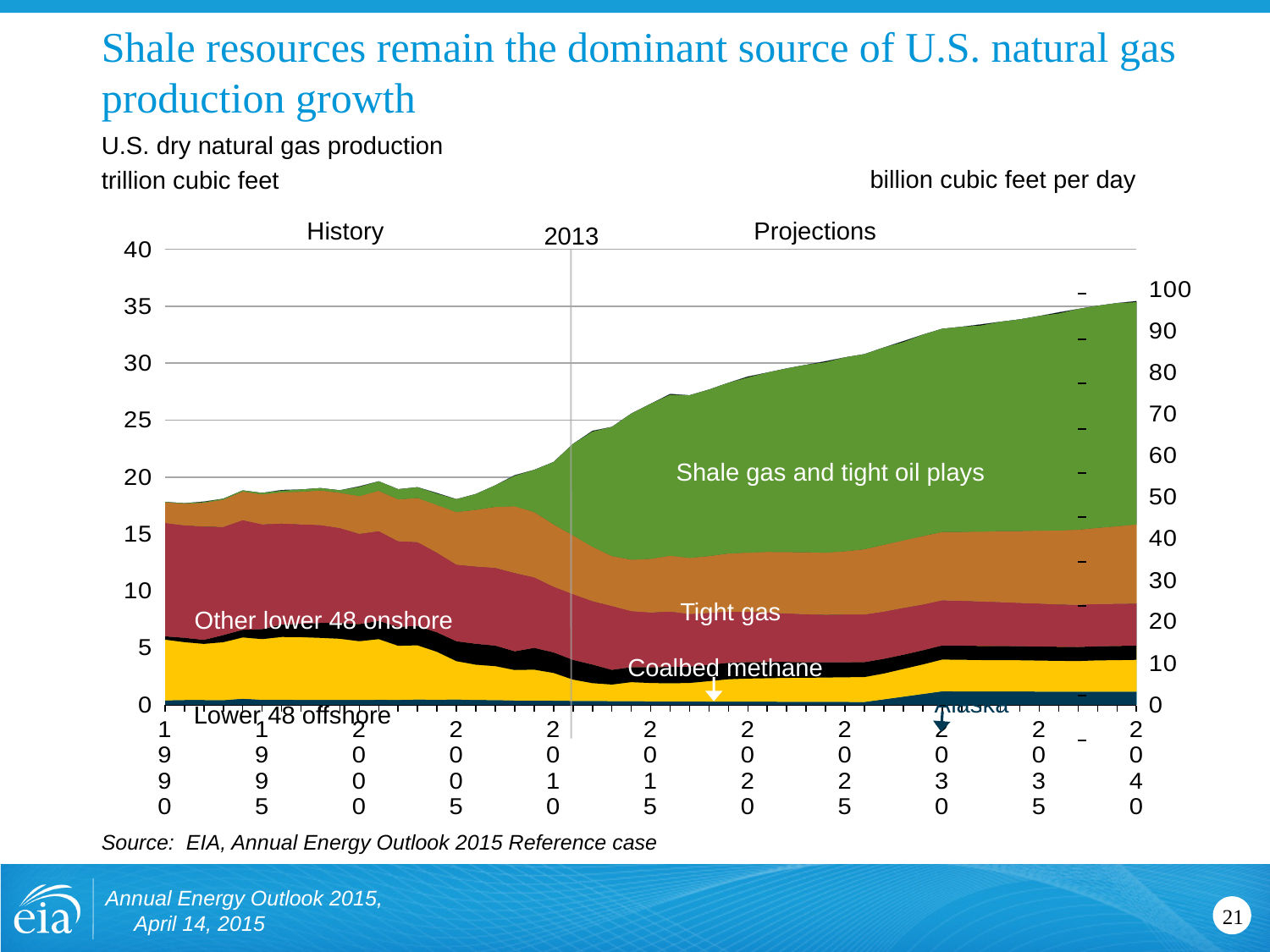
Which source contributes the largest share of production in 1990? Other lower 48 onshore In 2040, which is larger: production from shale gas and tight oil plays or from tight gas? Shale gas and tight oil plays What is the title of the slide's chart? U.S. dry natural gas production Is total dry natural gas production in 2013 greater or less than 20 trillion cubic feet? greater What unit is shown on the left vertical axis? trillion cubic feet How many year labels are shown on the x axis? 11 Is total dry natural gas production in 1990 greater or less than 20 trillion cubic feet? less Which year marks the boundary between History and Projections on the chart? 2013 Which source contributes the largest share of production in 2040? Shale gas and tight oil plays Is total dry natural gas production in 2040 greater or less than 30 trillion cubic feet? greater What kind of chart is shown on the slide? stacked area chart Does total U.S. dry natural gas production rise or fall between 2013 and 2040? rise